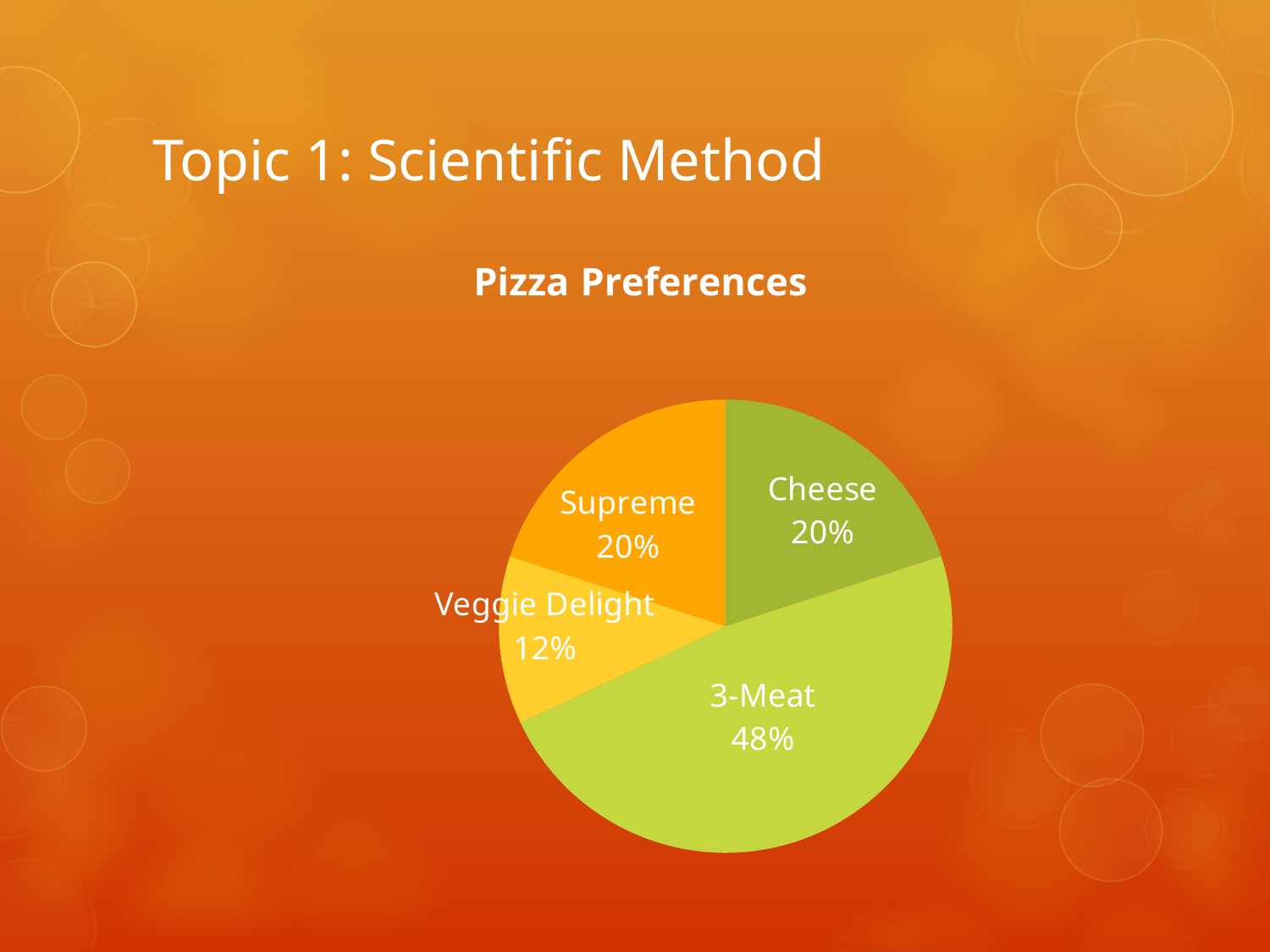
What is the combined share of Cheese and Supreme? 40% Which is larger, the share for Supreme or the share for Veggie Delight? Supreme What kind of chart is shown on the slide? pie chart Which pizza has the largest share of the pie? 3-Meat How many slices does the pie chart have? 4 Which pizza has the smallest share of the pie? Veggie Delight What percentage of the pie is Cheese? 20% What is the difference in percentage points between 3-Meat and Cheese? 28 What percentage of the pie is 3-Meat? 48% What percentage of the pie is Veggie Delight? 12% What is the title of the chart? Pizza Preferences What percentage of the pie is Supreme? 20%